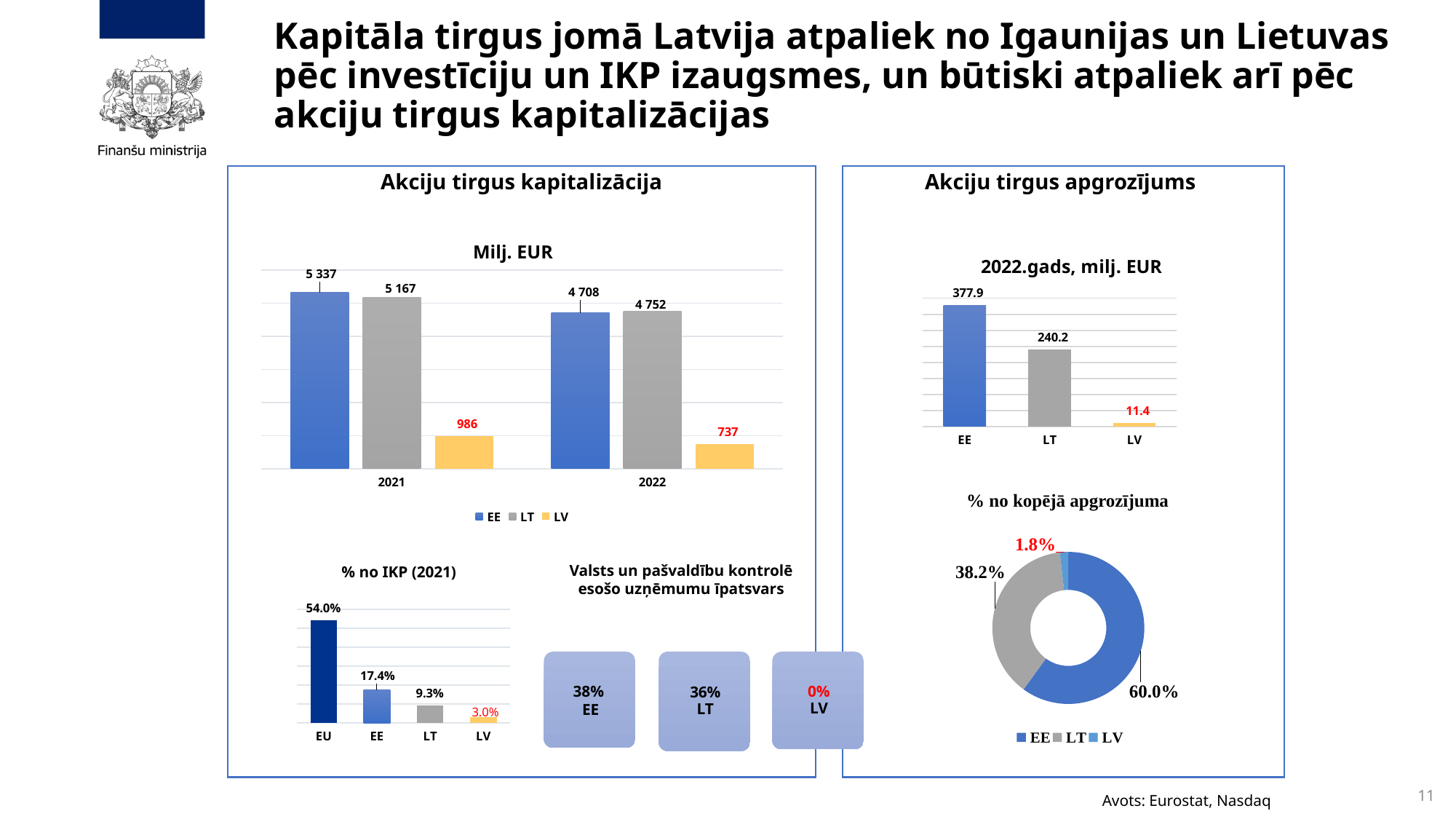
What kind of chart is the "% no kopējā apgrozījuma" chart? Donut (pie) chart In the "Milj. EUR" bar chart under "Akciju tirgus kapitalizācija", what is the difference between the EE values for 2021 and 2022? 629 How many series does the legend of the "Milj. EUR" bar chart under "Akciju tirgus kapitalizācija" list? 3 In the "2022.gads, milj. EUR" chart under "Akciju tirgus apgrozījums", what is the value for LT? 240.2 In the "Milj. EUR" bar chart under "Akciju tirgus kapitalizācija", what is the value for EE in 2021? 5 337 In the "% no kopējā apgrozījuma" chart, what share does LT have? 38.2% In the "% no IKP (2021)" chart, what is the value for EE? 17.4% In the "2022.gads, milj. EUR" chart under "Akciju tirgus apgrozījums", what is the difference between EE and LV? 366.5 How many categories are shown in the "% no IKP (2021)" chart? 4 In the "Milj. EUR" bar chart under "Akciju tirgus kapitalizācija", which series has the highest value in 2022? LT In the "% no IKP (2021)" chart, which category has the lowest value? LV In the "Milj. EUR" bar chart under "Akciju tirgus kapitalizācija", what is the value for LV in 2022? 737